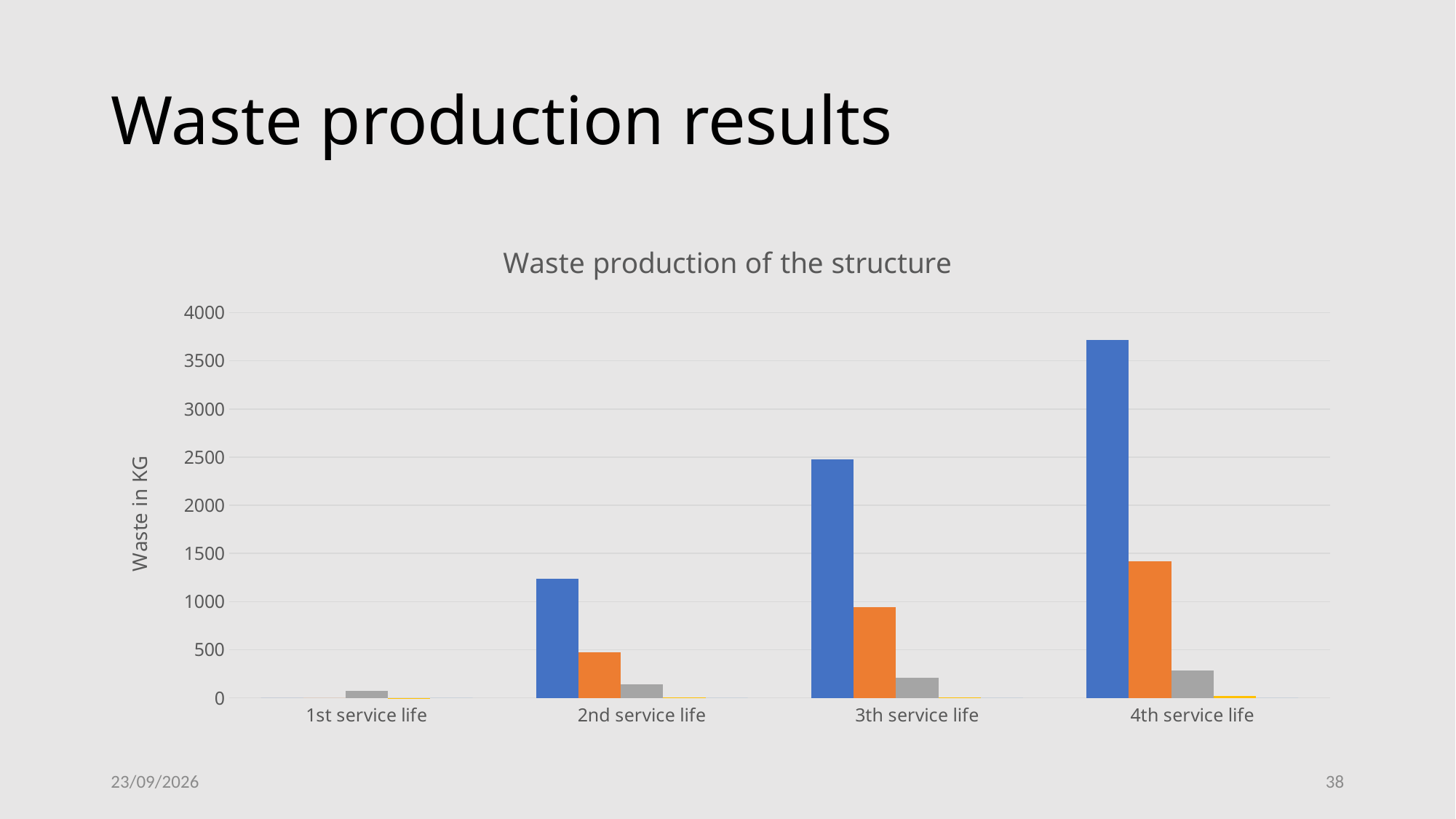
What kind of chart is shown on the slide? bar chart Which category has the shortest blue bar? 1st service life What is the title of the chart? Waste production of the structure In 4th service life, which is larger, the blue bar or the orange bar? the blue bar Which category has the tallest blue bar? 4th service life How many categories are shown on the x axis of the chart? 4 Is the blue bar for 2nd service life greater or less than 1000? greater Do the blue bars rise or fall from 1st service life to 4th service life? rise Is the blue bar for 3th service life greater or less than 2000? greater Is the blue bar for 4th service life greater or less than 3500? greater What is the label of the vertical axis? Waste in KG